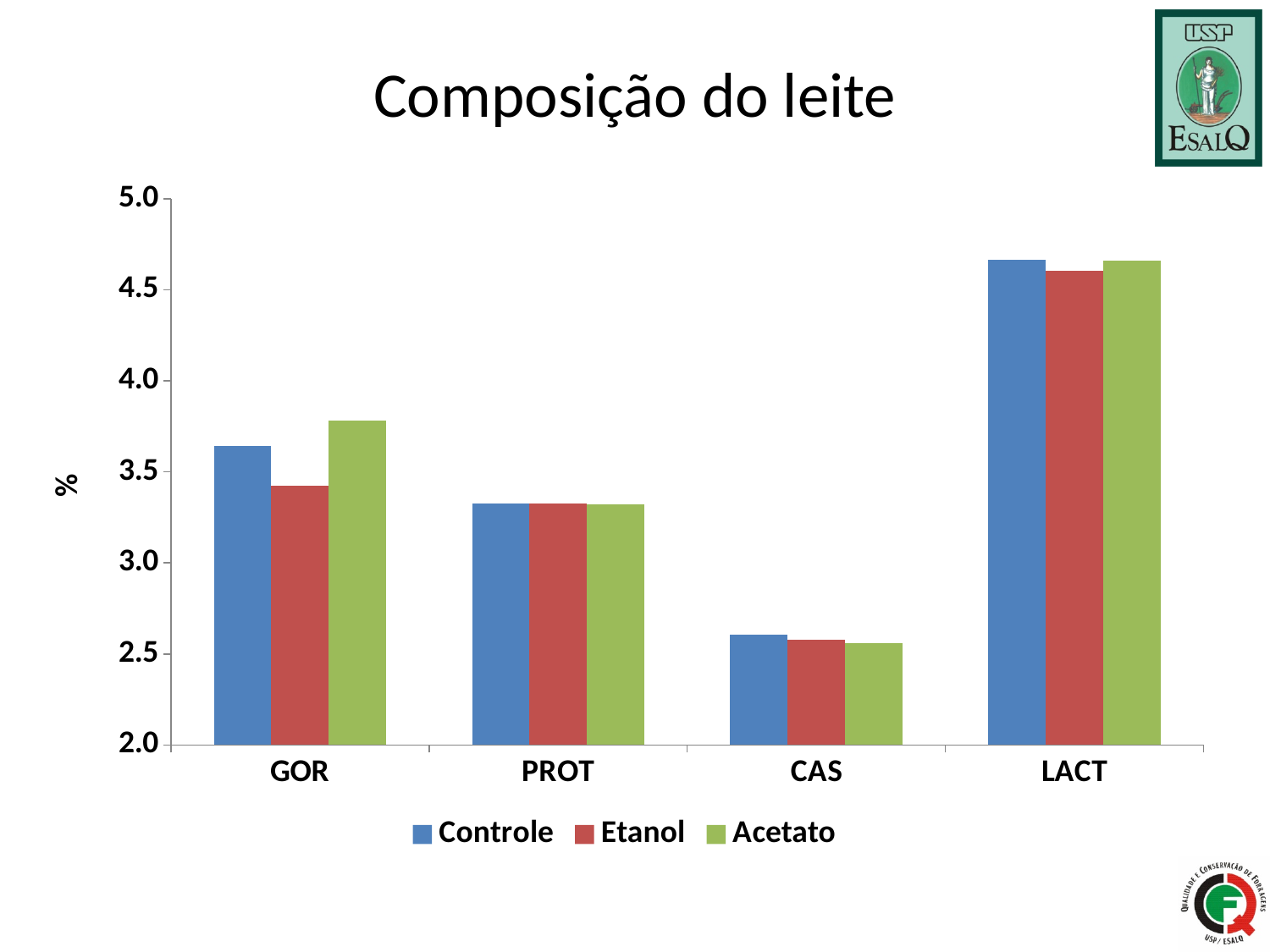
What is the label of the y axis? % In the GOR category, which series has the highest bar? Acetato In the GOR category, which series has the lowest bar? Etanol Is the value for Controle in the LACT category greater or less than 4.5? greater What is the title of the chart? Composição do leite How many series does the legend list? 3 What kind of chart is shown on the slide? bar chart Is the value for Acetato in the GOR category greater or less than 3.5? greater Which category has the highest values across all series? LACT In the GOR category, which is larger: Controle or Etanol? Controle How many categories are shown on the x axis? 4 Which category has the lowest values across all series? CAS